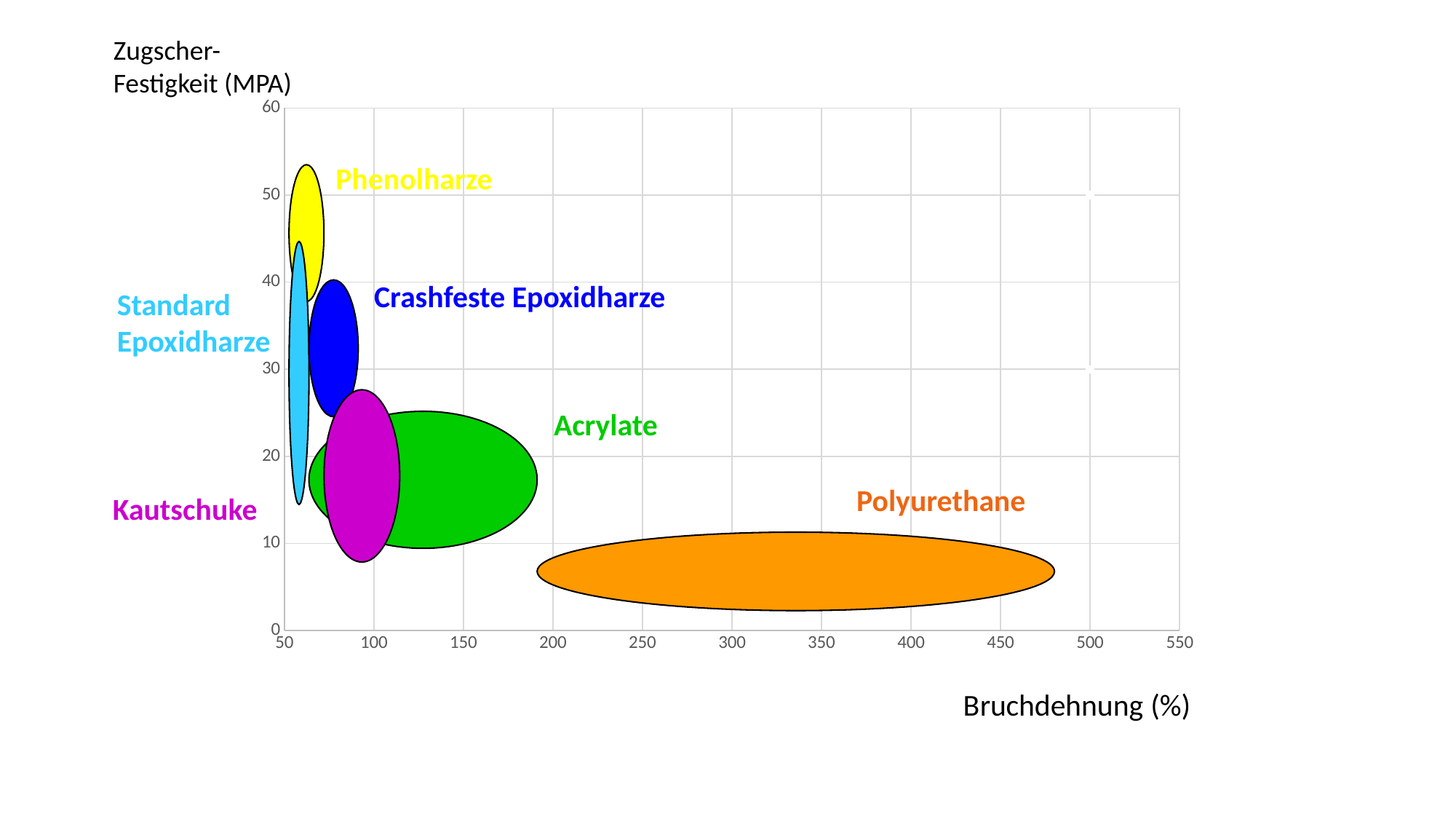
Which has the lower Zugscherfestigkeit, Phenolharze or Kautschuke? Kautschuke Is the Zugscherfestigkeit of Crashfeste Epoxidharze greater or less than 50 MPa? less How many material classes are plotted as regions on the chart? 6 Which material class has the lowest Zugscherfestigkeit on the chart? Polyurethane Is the Zugscherfestigkeit of Polyurethane greater or less than 20 MPa? less Which material class reaches the highest Bruchdehnung on the chart? Polyurethane Is the Bruchdehnung of Polyurethane greater or less than 200%? greater Which material class reaches the highest Zugscherfestigkeit on the chart? Phenolharze Which material class is shown in orange? Polyurethane What is the label of the x axis? Bruchdehnung (%) Which has the higher Bruchdehnung, Acrylate or Standard Epoxidharze? Acrylate